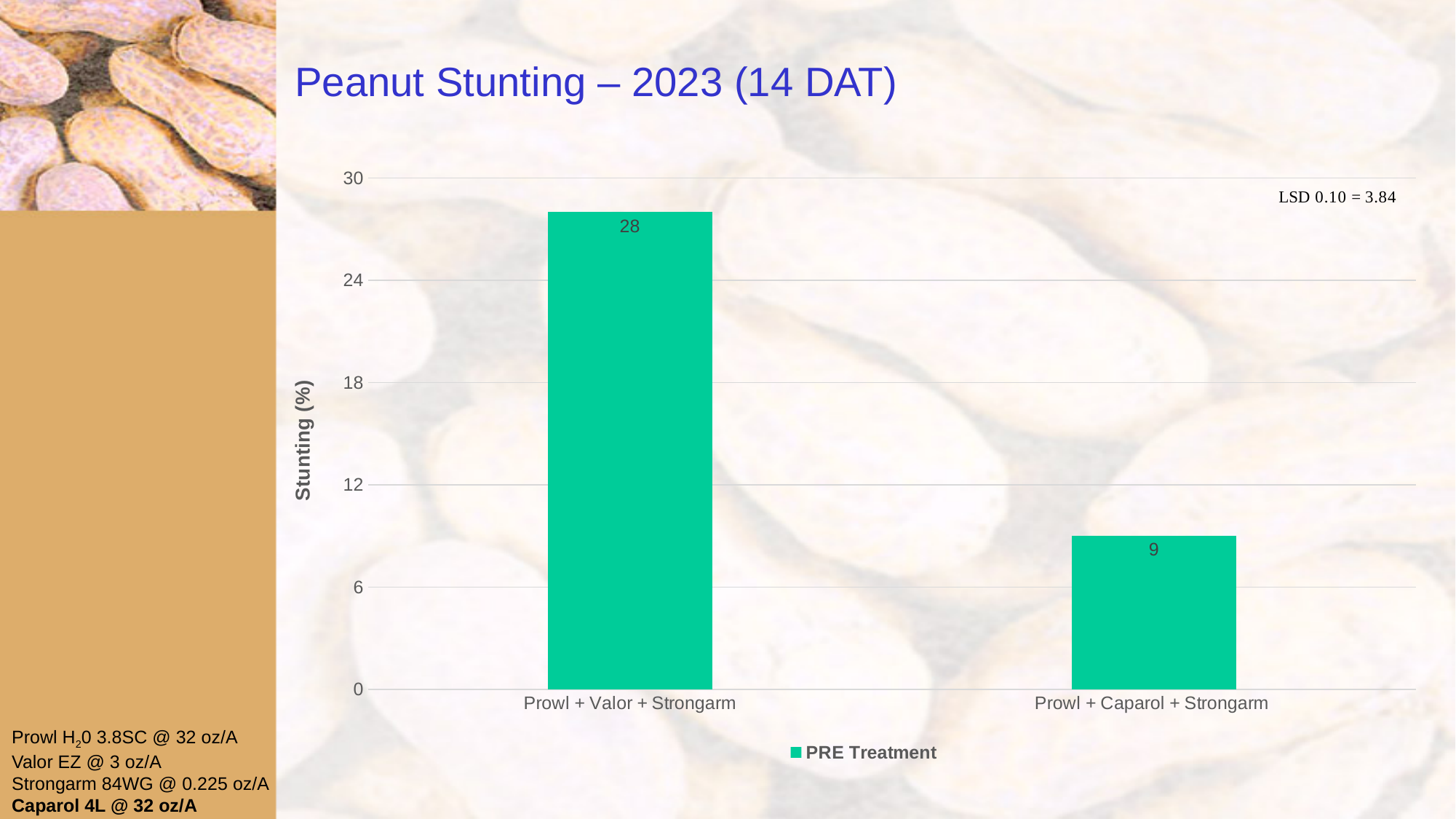
Which treatment has the lowest stunting percentage? Prowl + Caparol + Strongarm What is the title of the chart? Peanut Stunting – 2023 (14 DAT) What is the difference in stunting between Prowl + Valor + Strongarm and Prowl + Caparol + Strongarm? 19 How many series does the legend list? 1 Is the stunting value for Prowl + Valor + Strongarm greater or less than 24? greater How many treatments are shown in the chart? 2 What type of chart is shown on the slide? Bar chart Which has a larger stunting value, Prowl + Valor + Strongarm or Prowl + Caparol + Strongarm? Prowl + Valor + Strongarm Is the stunting value for Prowl + Caparol + Strongarm greater or less than 12? less What is the stunting value for Prowl + Valor + Strongarm? 28 What is the stunting value for Prowl + Caparol + Strongarm? 9 Which treatment has the highest stunting percentage? Prowl + Valor + Strongarm